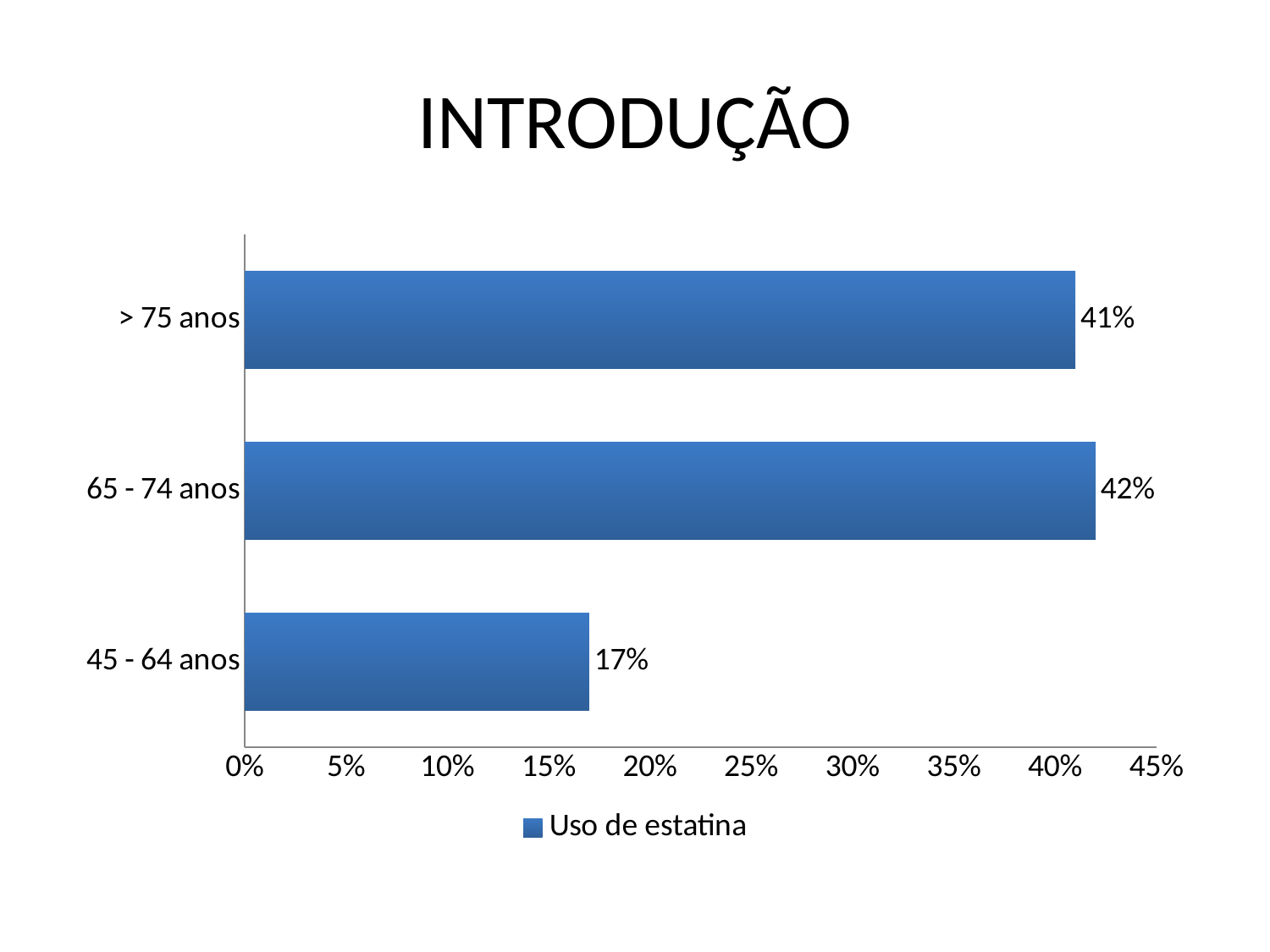
What is the value for 45 - 64 anos? 17% How many series does the legend list? 1 Is the value for 45 - 64 anos greater or less than 20%? less What kind of chart is shown on the slide? bar chart Which is larger, the value for 45 - 64 anos or the value for > 75 anos? > 75 anos Which age group has the lowest value? 45 - 64 anos What is the value for > 75 anos? 41% Is the value for 65 - 74 anos greater or less than 40%? greater How many age groups are shown in the chart? 3 What is the value for 65 - 74 anos? 42% What is the difference between the values for > 75 anos and 45 - 64 anos? 24% What is the difference between the values for 65 - 74 anos and 45 - 64 anos? 25%